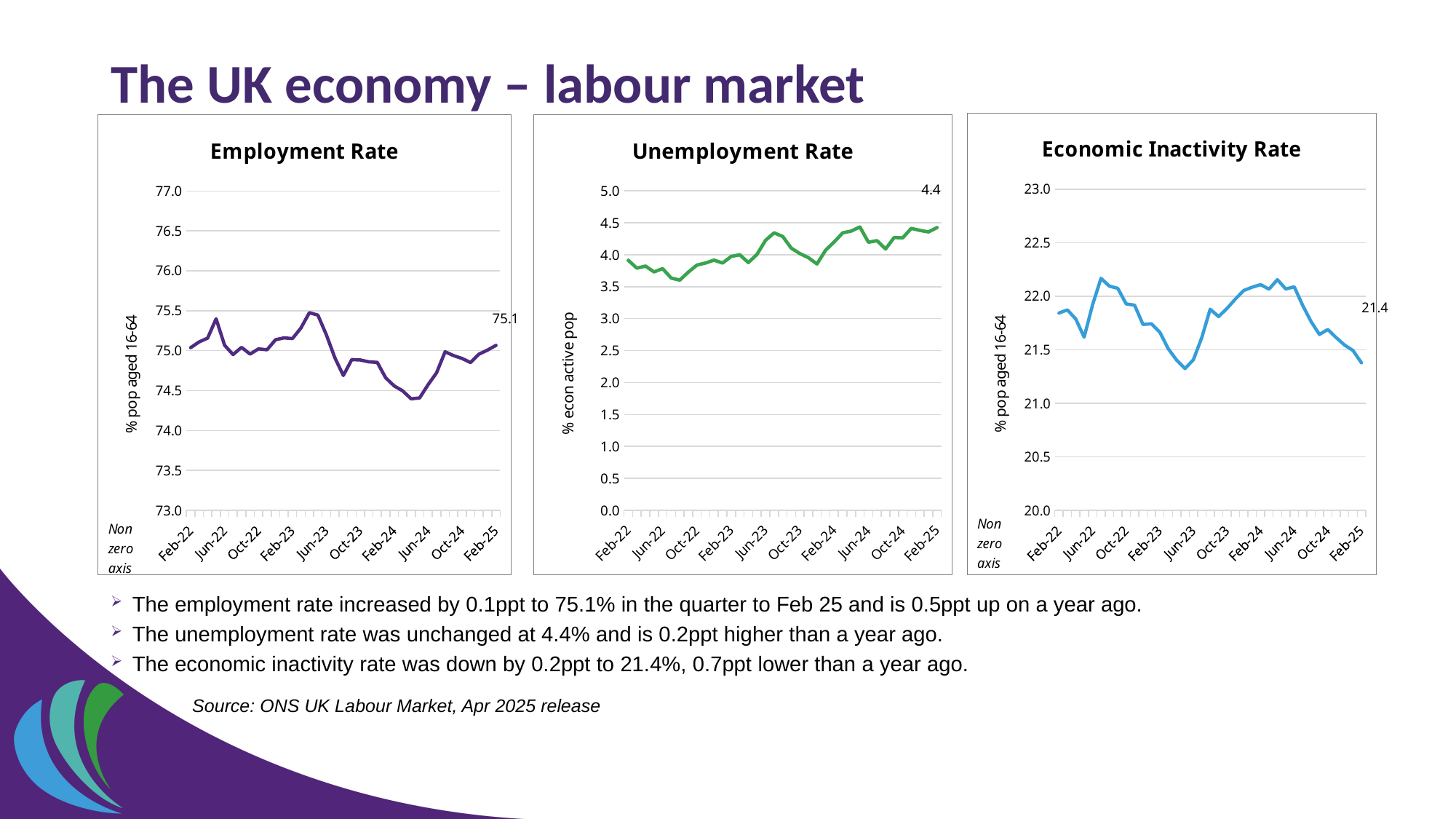
On the Unemployment Rate chart, is the value at Feb-25 higher or lower than at Feb-22? Higher On the Employment Rate chart, is the value at Jun-23 greater or less than 75.0? greater On the Unemployment Rate chart, is the value at Oct-22 greater or less than 4.0? less What kind of chart is the Unemployment Rate chart? Line chart On the Economic Inactivity Rate chart, does the line rise or fall between Jun-24 and Feb-25? Fall On the Unemployment Rate chart, what value is labelled at Feb-25? 4.4 On the Economic Inactivity Rate chart, is the value at Feb-24 greater or less than 21.5? greater On the Employment Rate chart, which is higher: the value at Jun-23 or the value at Jun-24? Jun-23 What is the y-axis label on the Unemployment Rate chart? % econ active pop On the Economic Inactivity Rate chart, what value is labelled at Feb-25? 21.4 On the Employment Rate chart, what value is labelled at Feb-25? 75.1